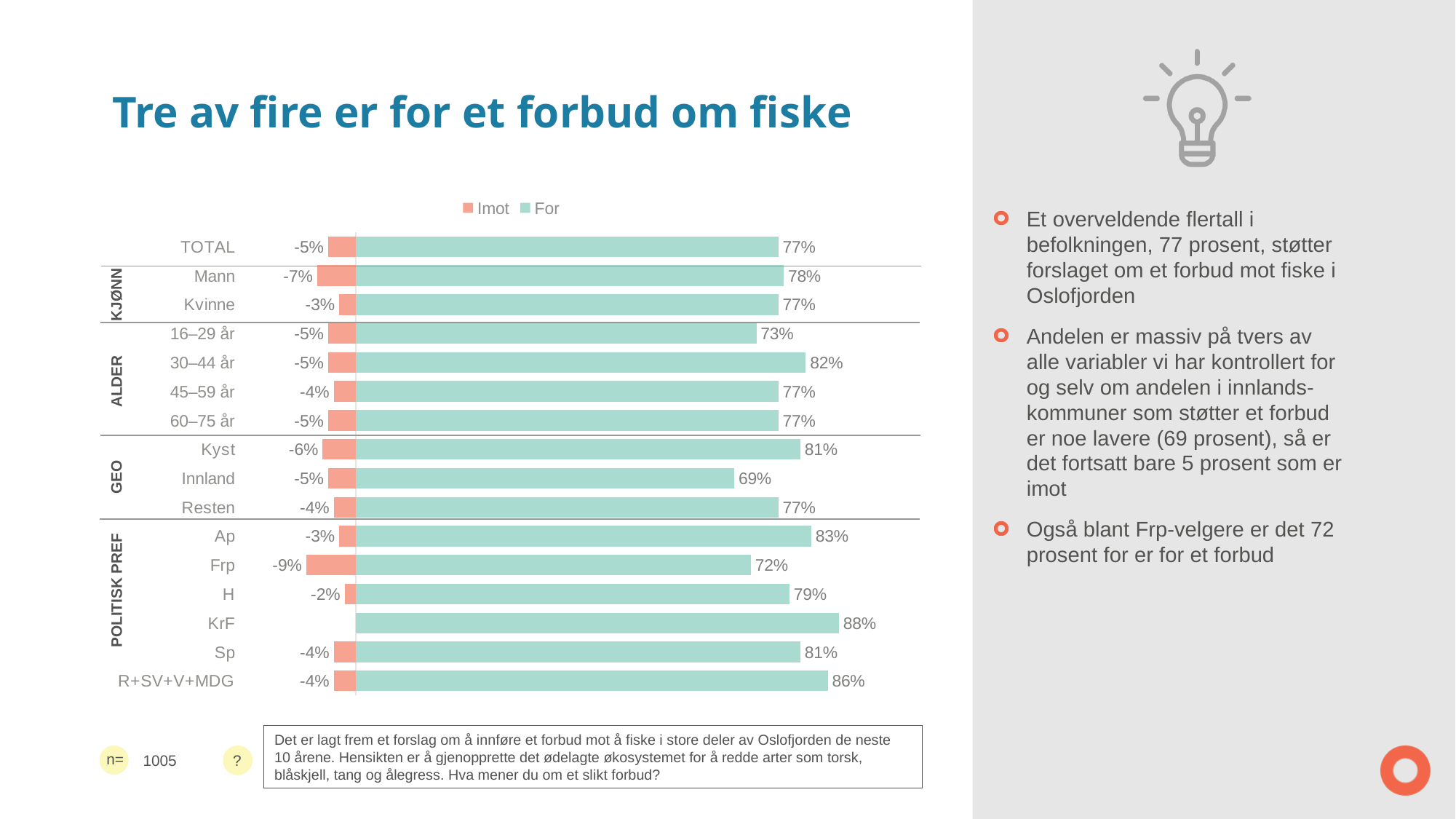
What is the 'For' value for TOTAL? 77% Which has a larger 'For' value, Ap or Frp? Ap How many categories are plotted on the chart? 16 What is the difference between the 'For' values for 30–44 år and 16–29 år? 9 percentage points Which category has the lowest 'For' value? Innland What kind of chart is shown on the slide? bar chart What is the 'For' value for Innland? 69% How many series does the legend list? 2 Which category has the largest 'Imot' share? Frp Which category has the highest 'For' value? KrF What are the two series named in the legend? Imot and For What is the 'Imot' value for Frp? -9%